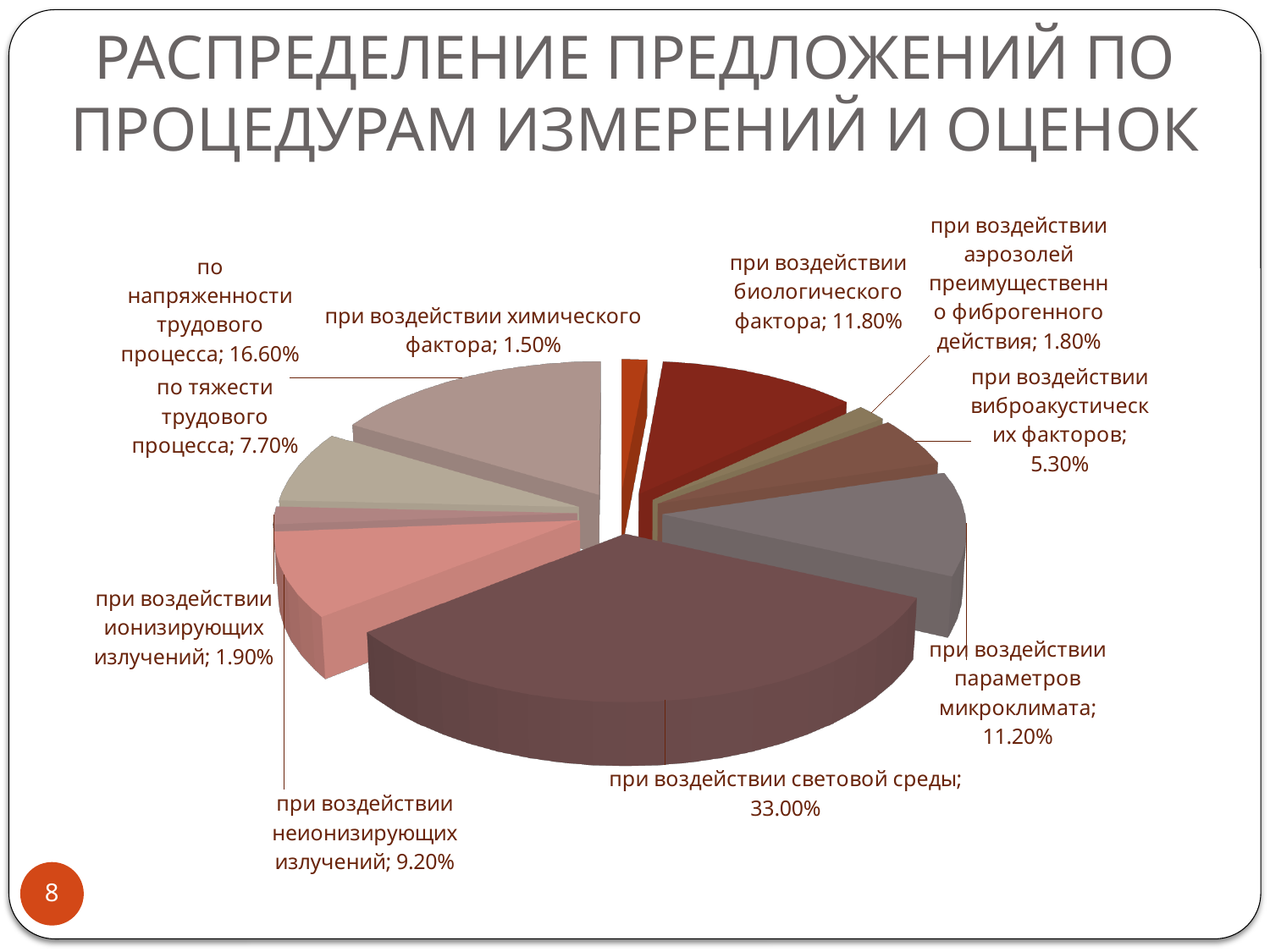
Which category has the largest share of the pie? при воздействии световой среды What is the difference between the shares for 'при воздействии биологического фактора' and 'при воздействии параметров микроклимата'? 0.60% What share is shown for 'при воздействии виброакустических факторов'? 5.30% What is the title of the chart on the slide? РАСПРЕДЕЛЕНИЕ ПРЕДЛОЖЕНИЙ ПО ПРОЦЕДУРАМ ИЗМЕРЕНИЙ И ОЦЕНОК How many slices does the pie chart have? 10 What is the difference between the shares for 'при воздействии световой среды' and 'по напряженности трудового процесса'? 16.40% Which category has the smallest share of the pie? при воздействии химического фактора What share is shown for 'по напряженности трудового процесса'? 16.60% What share is shown for 'при воздействии неионизирующих излучений'? 9.20% What kind of chart is shown on the slide? pie chart What share is shown for 'при воздействии световой среды'? 33.00% Which has a larger share: 'по тяжести трудового процесса' or 'при воздействии неионизирующих излучений'? при воздействии неионизирующих излучений